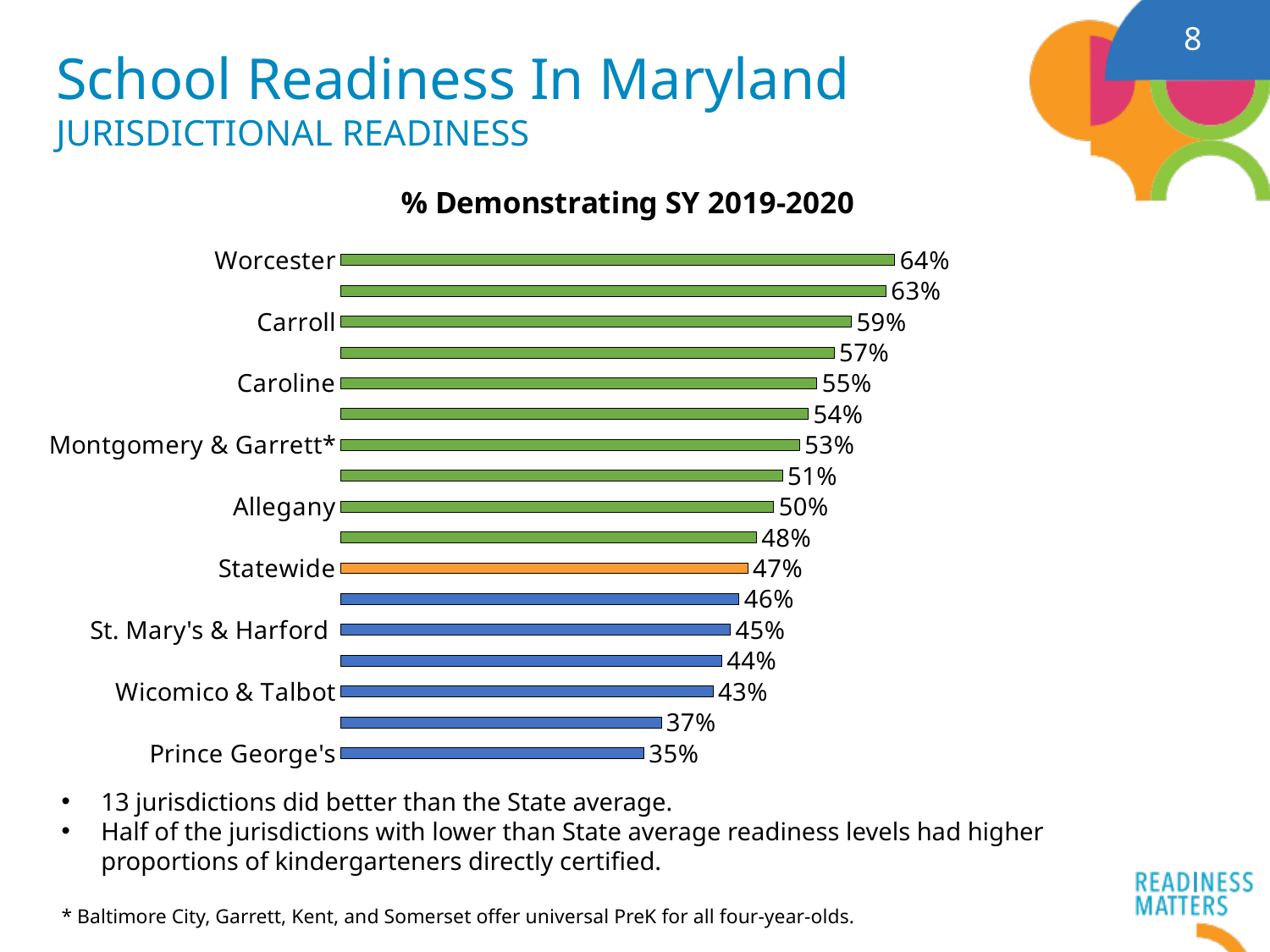
What is the value for Worcester? 64% What is the difference between the values for Worcester and Statewide? 17% What is the value for Statewide? 47% How many bars are plotted in the chart? 17 Which labeled category has the lowest value? Prince George's Which is larger, the value for Allegany or the value for Wicomico & Talbot? Allegany What is the value for Prince George's? 35% Which labeled category has the highest value? Worcester What is the value for Montgomery & Garrett*? 53% What is the title of the chart? % Demonstrating SY 2019-2020 What is the difference between the values for Carroll and Caroline? 4% What kind of chart is shown on the slide? Bar chart